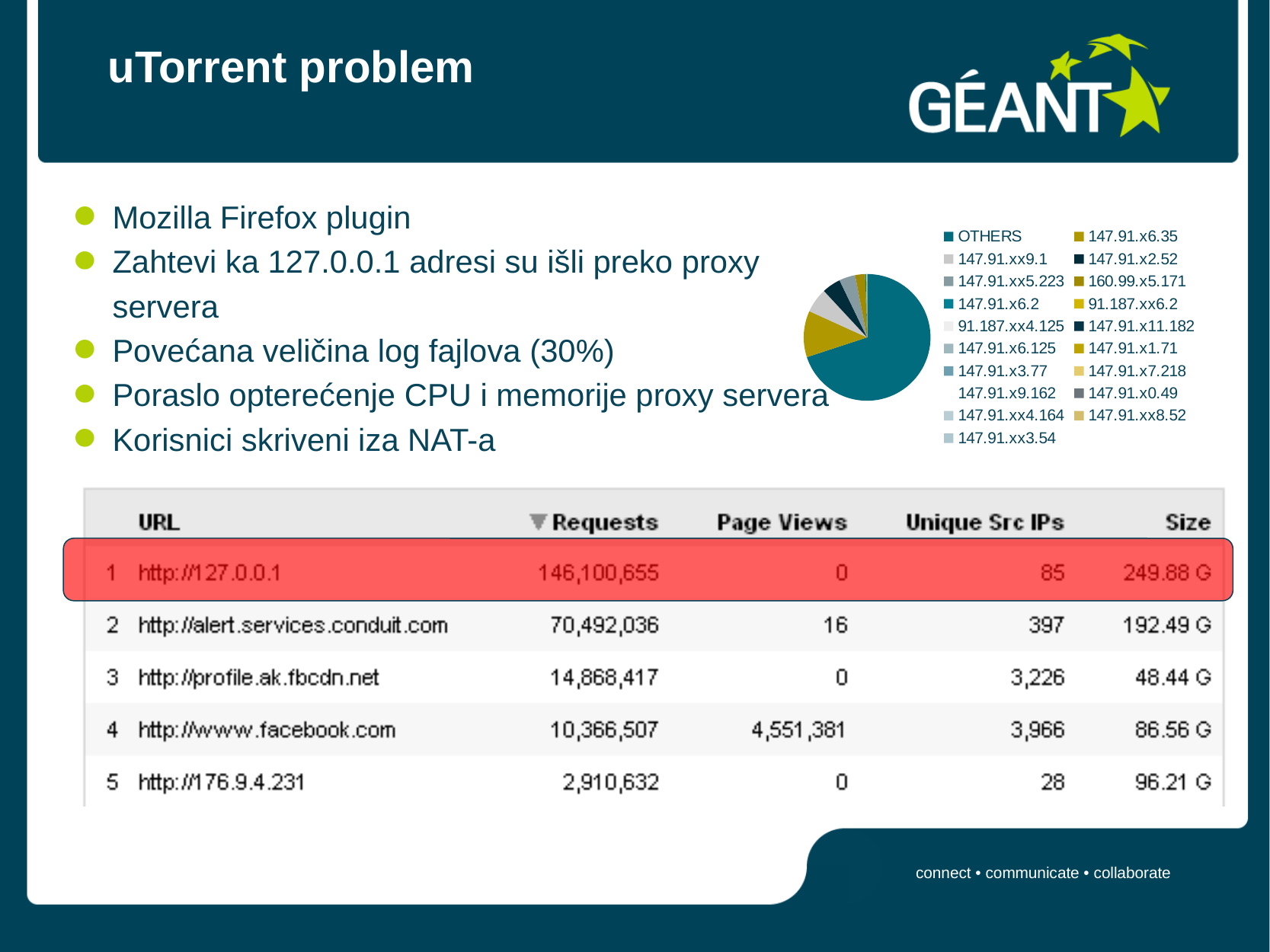
What is the last entry listed in the pie chart's legend? 147.91.xx3.54 What kind of chart is shown on the slide? pie chart Which category has the largest slice in the pie chart? OTHERS How many entries does the legend of the pie chart list? 19 Which slice is larger in the pie chart, OTHERS or 147.91.x6.35? OTHERS What is the first entry listed in the pie chart's legend? OTHERS